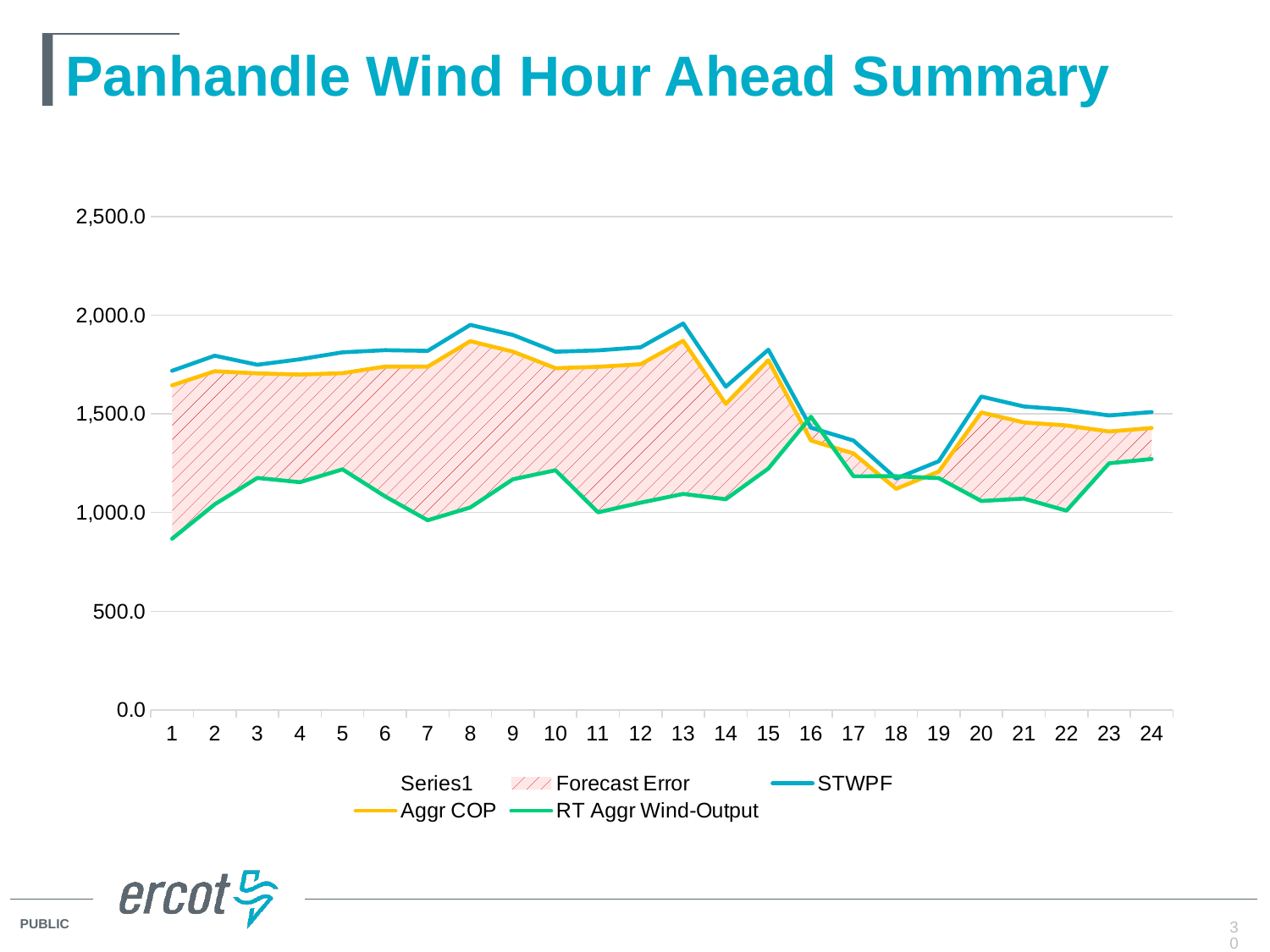
What kind of chart is shown on the slide? combination area and line chart How many entries does the legend list? 5 How many hours are plotted along the x axis? 24 Is the Aggr COP value at hour 18 greater or less than 1,500? less Is the STWPF value at hour 13 greater or less than 2,000? less Is the STWPF value at hour 1 greater or less than 1,500? greater At which hour is STWPF lowest? 18 What is the title of the chart? Panhandle Wind Hour Ahead Summary At hour 1, which is larger: STWPF or RT Aggr Wind-Output? STWPF At which hour is RT Aggr Wind-Output lowest? 1 Does the STWPF line rise or fall from hour 18 to hour 20? rise